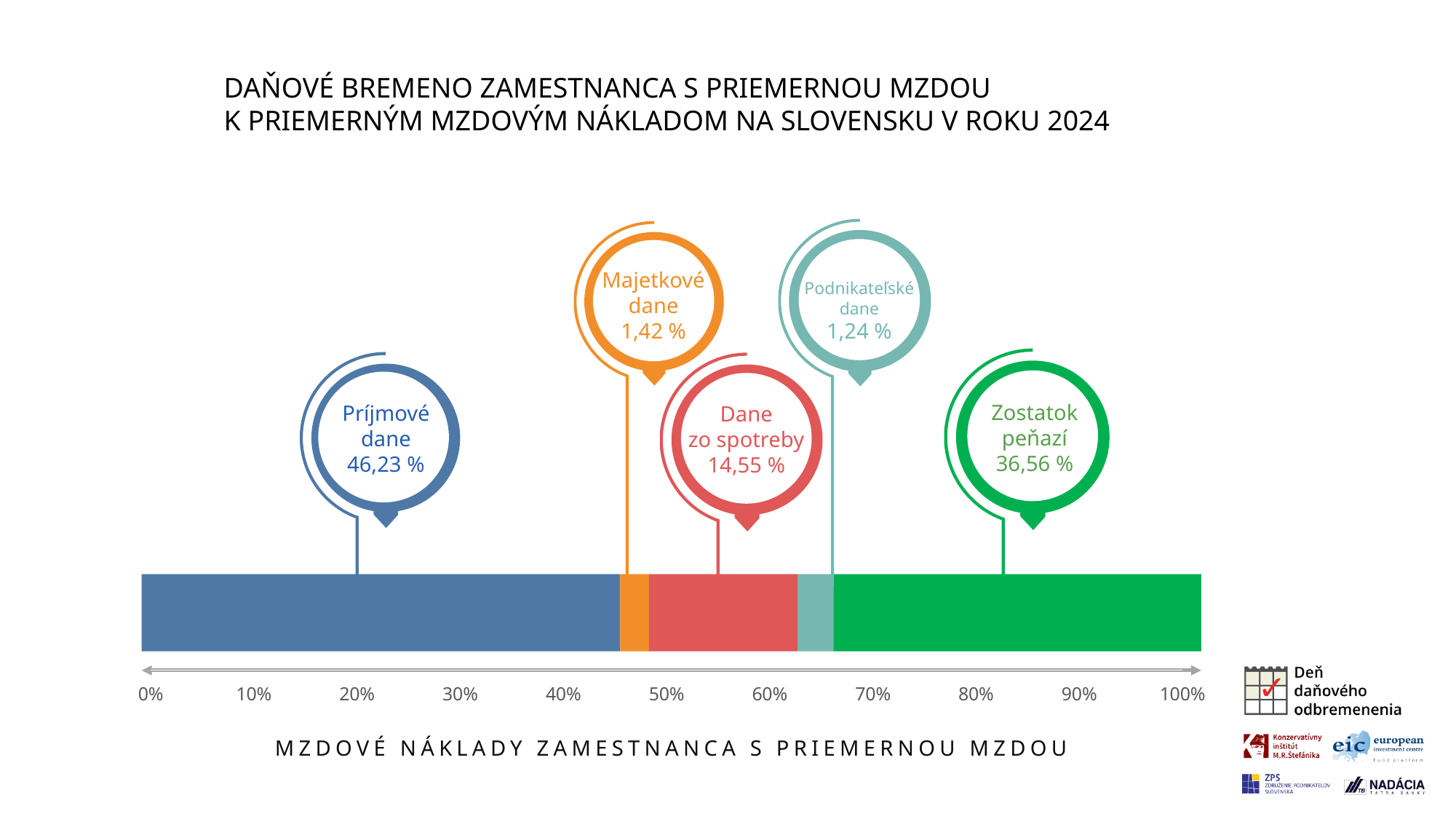
What is the value for Príjmové dane? 46,23 % What kind of chart is shown on the slide? Stacked bar chart Is the value for Príjmové dane greater or less than 40%? greater What is the difference between Príjmové dane and Zostatok peňazí? 9,67 % Which is larger, Dane zo spotreby or Zostatok peňazí? Zostatok peňazí What is the value for Dane zo spotreby? 14,55 % What is the value for Zostatok peňazí? 36,56 % What is the total of all segments in the bar? 100,00 % Which segment has the highest value? Príjmové dane How many segments does the bar have? 5 What is the value for Majetkové dane? 1,42 % Which segment has the lowest value? Podnikateľské dane